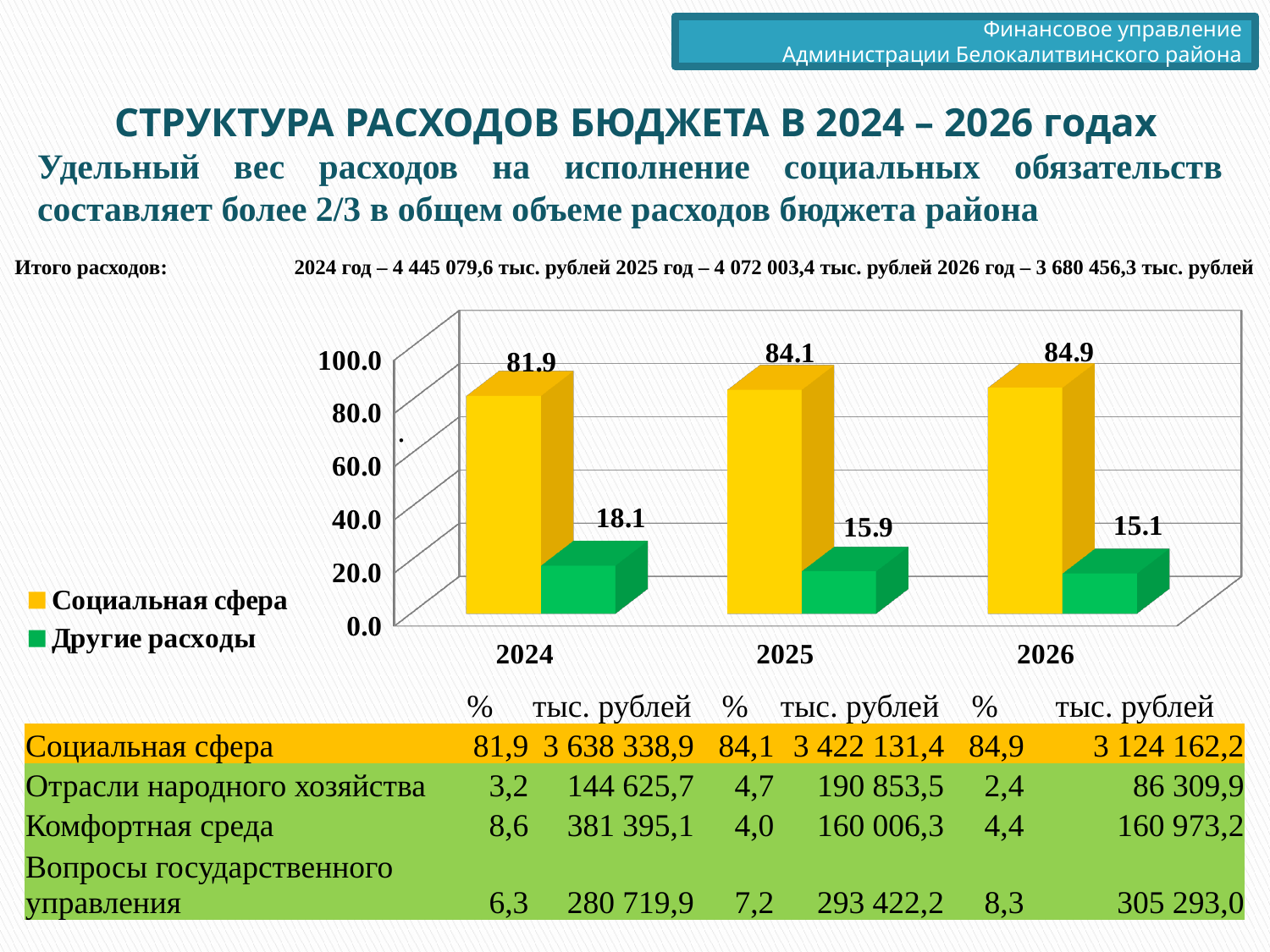
What is the value for Другие расходы in 2026? 15.1 What is the value for Социальная сфера in 2024? 81.9 In which year is the value for Другие расходы the lowest? 2026 How many series does the chart legend list? 2 Do the values for Социальная сфера rise or fall from 2024 to 2026? rise In which year is the value for Социальная сфера the highest? 2026 What is the value for Другие расходы in 2025? 15.9 What kind of chart is shown on the slide? bar chart Which is larger in 2024: the value for Социальная сфера or for Другие расходы? Социальная сфера What is the difference between the Социальная сфера and Другие расходы values in 2025? 68.2 How many years are shown on the x axis of the chart? 3 Is the value for Другие расходы in 2024 greater or less than 20.0? less